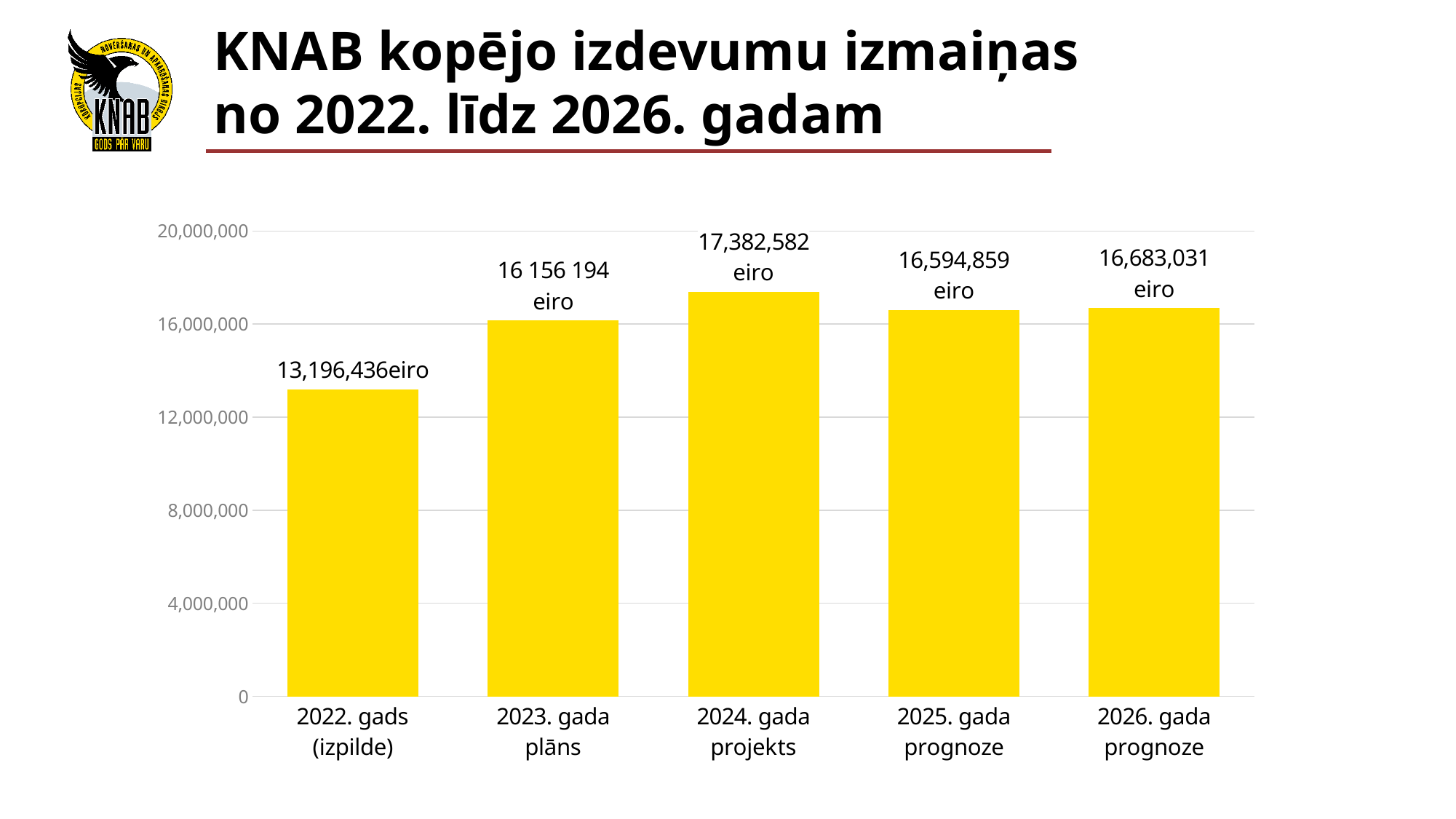
Does the value rise or fall from 2022. gads (izpilde) to 2023. gada plāns? rise What is the difference between the values for 2026. gada prognoze and 2025. gada prognoze? 88,172 eiro What kind of chart is shown on the slide? bar chart How many bars are shown in the chart? 5 What is the value shown for 2026. gada prognoze? 16,683,031 eiro Which category has the lowest value? 2022. gads (izpilde) What is the value shown for 2022. gads (izpilde)? 13,196,436eiro What is the value shown for 2024. gada projekts? 17,382,582 eiro Is the value for 2022. gads (izpilde) greater or less than 12,000,000? greater Which category has the highest value? 2024. gada projekts Which is larger, the value for 2023. gada plāns or the value for 2024. gada projekts? 2024. gada projekts What is the difference between the values for 2024. gada projekts and 2022. gads (izpilde)? 4,186,146 eiro